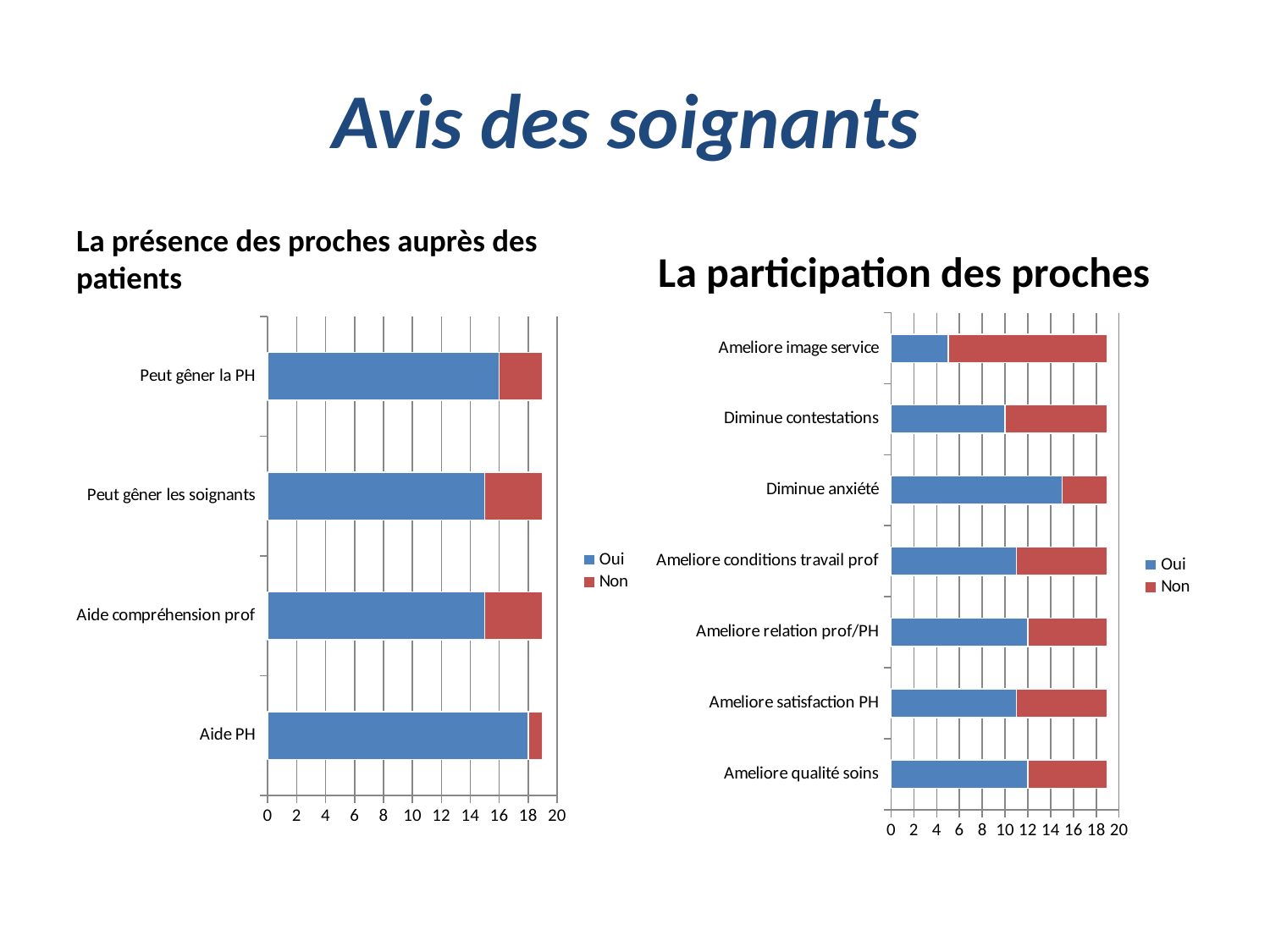
In the 'La participation des proches' chart, which category has the lowest 'Oui' value? Ameliore image service In the 'La participation des proches' chart, which category has the highest 'Oui' value? Diminue anxiété What are the two legend entries in the 'La présence des proches auprès des patients' chart? Oui and Non How many series does the legend of the 'La participation des proches' chart list? 2 In the 'La participation des proches' chart, which is larger: the 'Oui' value for 'Diminue anxiété' or for 'Diminue contestations'? Diminue anxiété In the 'La présence des proches auprès des patients' chart, which category has the highest 'Oui' value? Aide PH How many categories does the 'La participation des proches' chart show? 7 In the 'La participation des proches' chart, is the 'Oui' value for 'Ameliore image service' greater or less than 8? less In the 'La présence des proches auprès des patients' chart, is the 'Oui' value for 'Aide PH' greater or less than 16? greater How many categories does the 'La présence des proches auprès des patients' chart show? 4 What kind of chart is used for 'La présence des proches auprès des patients'? Stacked bar chart In the 'La participation des proches' chart, which category has the largest 'Non' value? Ameliore image service